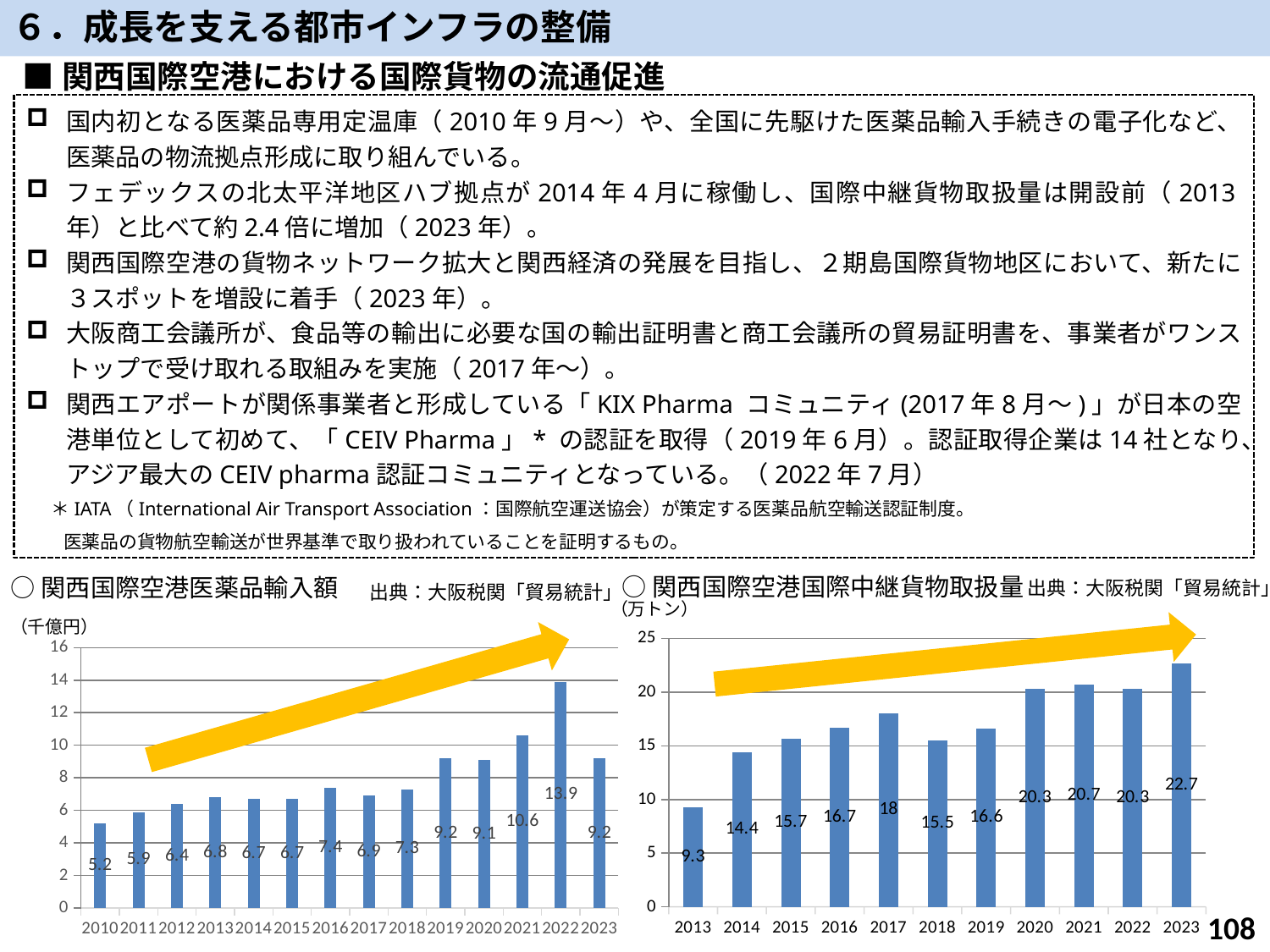
In the 関西国際空港国際中継貨物取扱量 chart, which is larger, the value for 2018 or the value for 2019? 2019 What type of chart is the 関西国際空港国際中継貨物取扱量 chart? bar chart In the 関西国際空港医薬品輸入額 chart, what is the difference between the 2022 value and the 2023 value? 4.7 In the 関西国際空港国際中継貨物取扱量 chart, what is the value for 2017? 18 In the 関西国際空港医薬品輸入額 chart, which year has the highest value? 2022 In the 関西国際空港国際中継貨物取扱量 chart, what is the difference between the 2023 value and the 2013 value? 13.4 In the 関西国際空港国際中継貨物取扱量 chart, what is the value for 2023? 22.7 In the 関西国際空港国際中継貨物取扱量 chart, which year has the lowest value? 2013 In the 関西国際空港医薬品輸入額 chart, which year has the lowest value? 2010 In the 関西国際空港医薬品輸入額 chart, what is the value for 2022? 13.9 How many years are shown in the 関西国際空港医薬品輸入額 chart? 14 In the 関西国際空港医薬品輸入額 chart, what is the value for 2010? 5.2